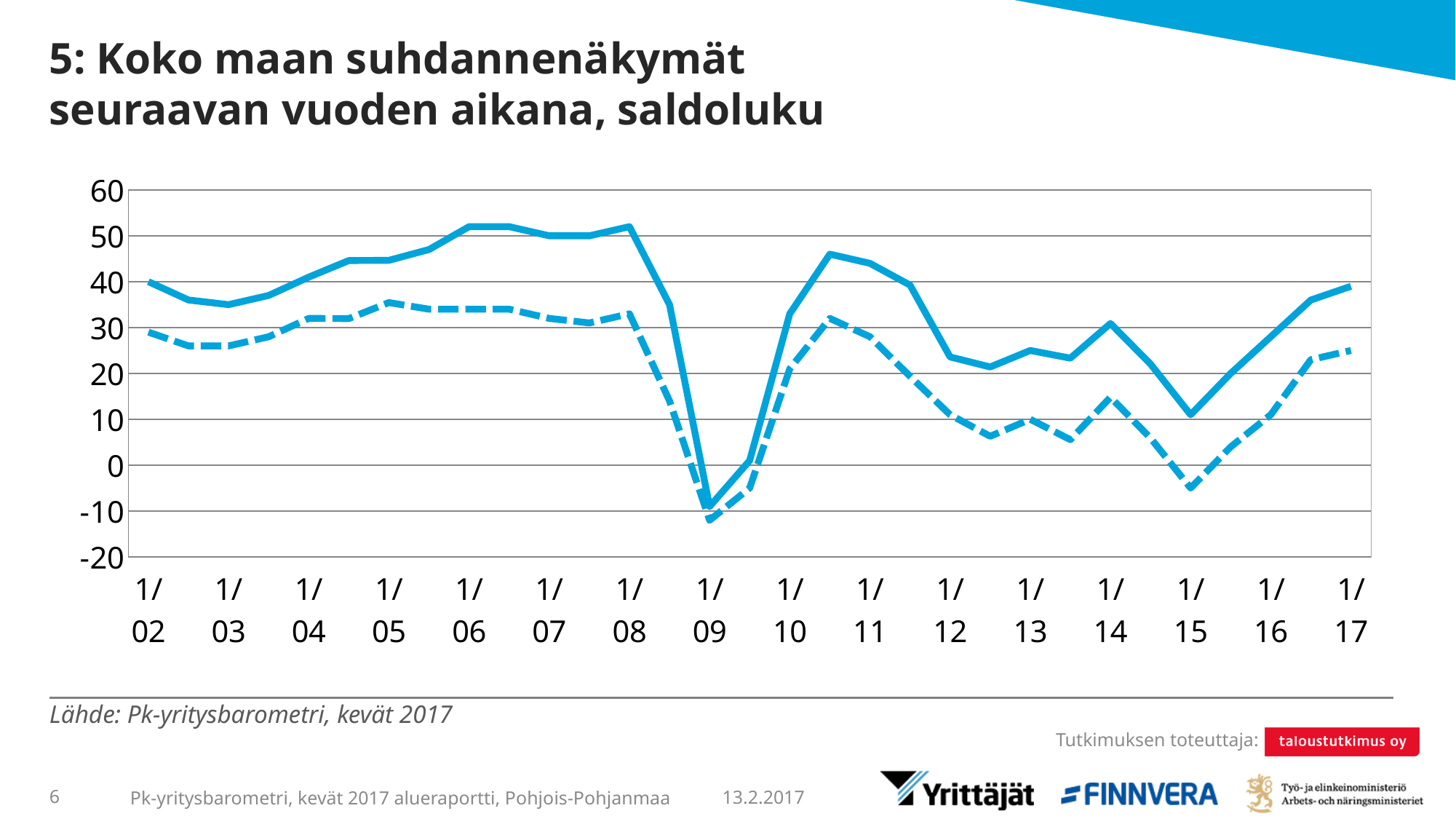
Is the value of the solid line at 1/09 greater or less than 0? less What kind of chart is shown on the slide? line chart Is the value of the dashed line at 1/15 greater or less than 0? less Does the solid line rise or fall between 1/15 and 1/17? rise At 1/08, which line has the higher value, the solid line or the dashed line? the solid line Is the value of the solid line at 1/06 greater or less than 40? greater How many lines are plotted on the chart? 2 What is the title of the chart on the slide? 5: Koko maan suhdannenäkymät seuraavan vuoden aikana, saldoluku How many time points are labelled on the x axis of the chart? 16 At which x-axis label does the solid line reach its lowest value? 1/09